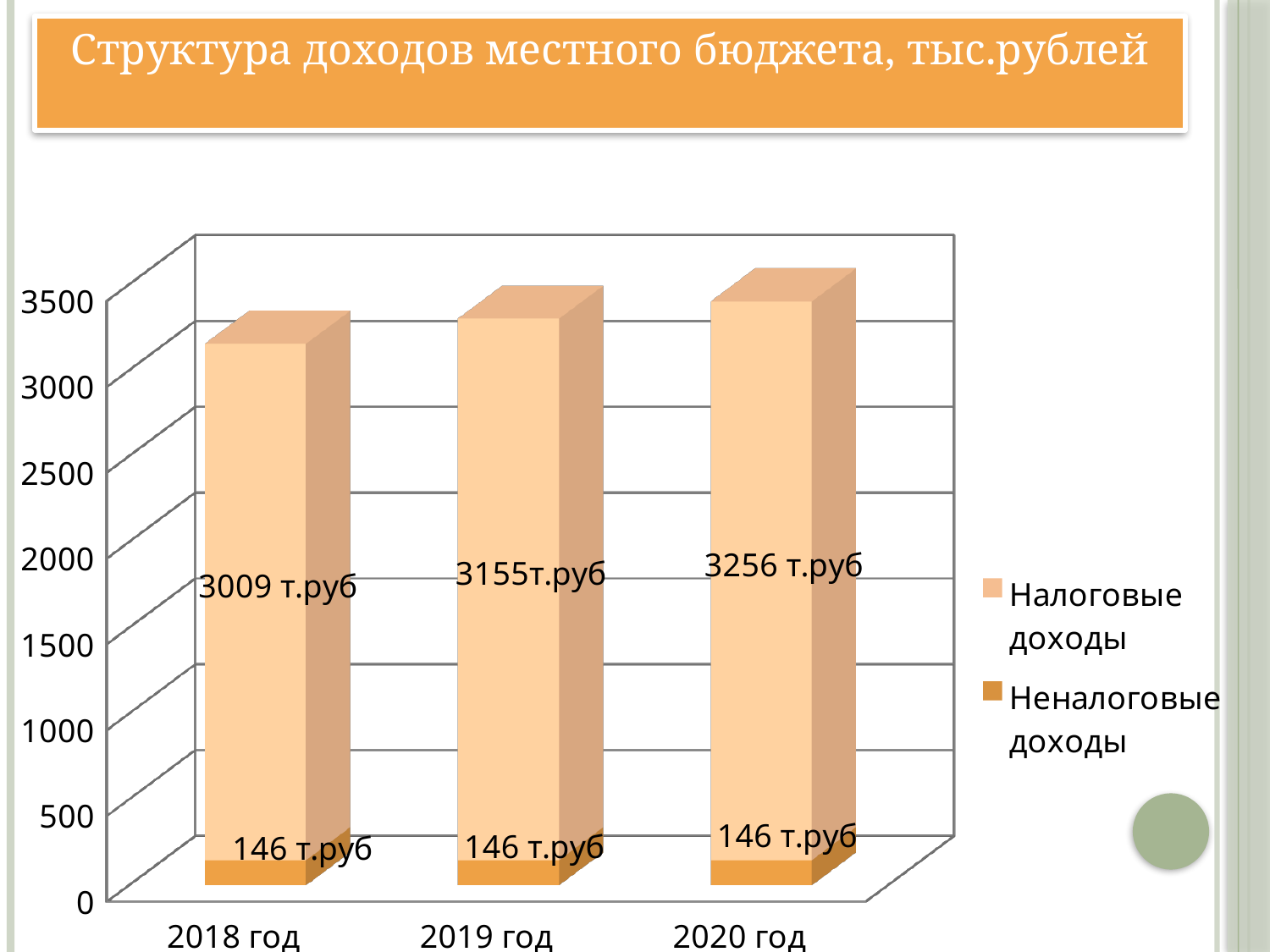
Which year has the highest value for Налоговые доходы? 2020 год What is the value of Налоговые доходы for 2018 год? 3009 т.руб Do the values for Налоговые доходы rise or fall from 2018 год to 2020 год? Rise Which is larger: Налоговые доходы in 2019 год or in 2018 год? 2019 год What kind of chart is shown on the slide? Stacked bar chart What is the difference between Налоговые доходы in 2020 год and 2018 год? 247 т.руб What is the total of the stacked bar for 2019 год? 3301 т.руб How many years are shown on the x axis? 3 What is the value of Неналоговые доходы for 2019 год? 146 т.руб Which year has the lowest value for Налоговые доходы? 2018 год How many series does the legend list? 2 What is the value of Налоговые доходы for 2020 год? 3256 т.руб